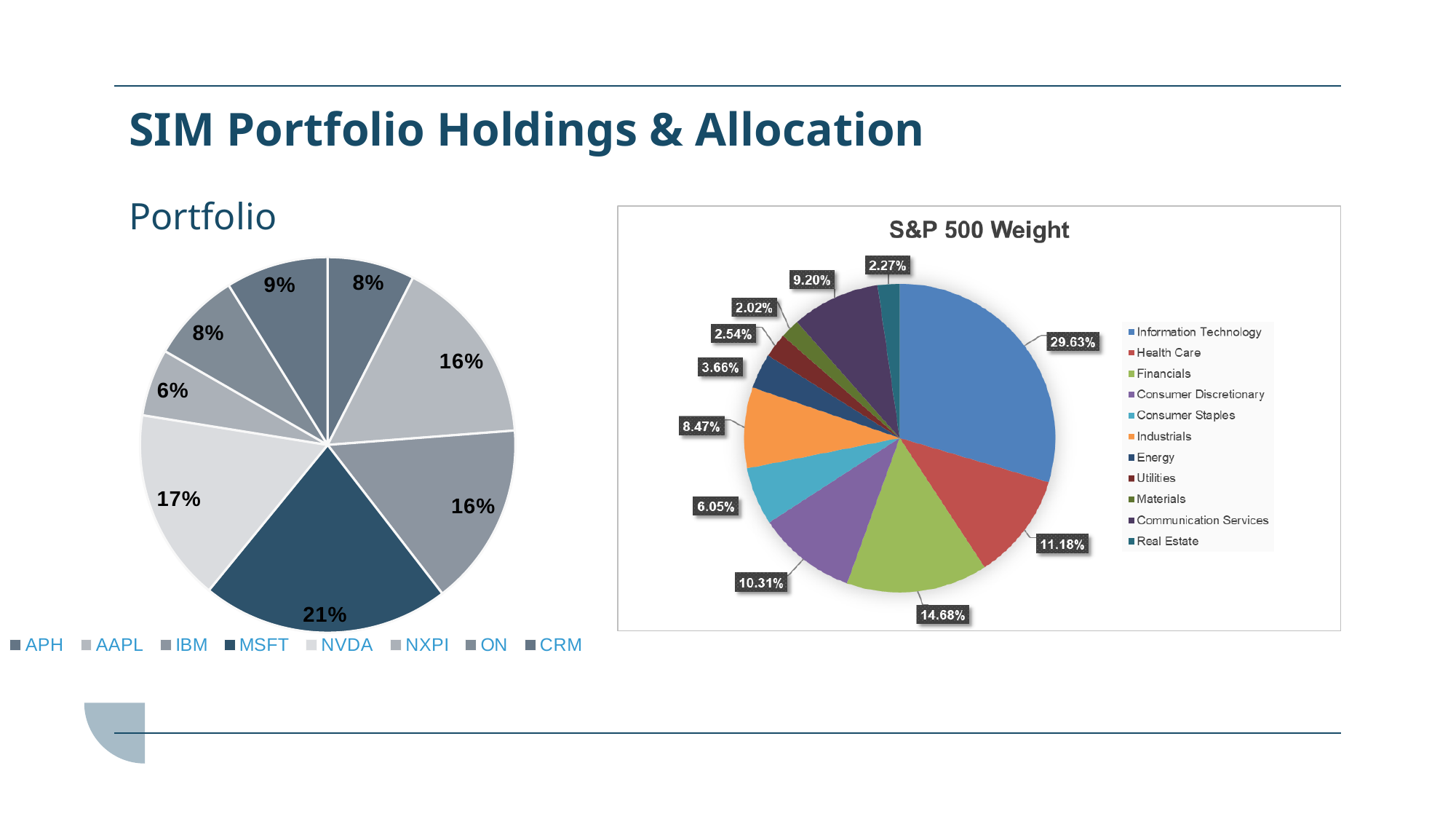
What is the title of the chart on the right side of the slide? S&P 500 Weight In the S&P 500 Weight chart, what is the weight of Information Technology? 29.63% In the Portfolio chart, what share does MSFT hold? 21% What type of chart is the Portfolio chart on the left? Pie chart In the Portfolio chart, which holding has the largest share? MSFT How many sectors does the legend of the S&P 500 Weight chart list? 11 How many holdings does the legend of the Portfolio chart list? 8 In the S&P 500 Weight chart, which sector has the smallest weight? Materials In the S&P 500 Weight chart, what is the weight of Financials? 14.68% In the S&P 500 Weight chart, which sector has the largest weight? Information Technology In the S&P 500 Weight chart, what is the difference between the Health Care and Consumer Discretionary weights? 0.87% In the S&P 500 Weight chart, which is larger, Industrials or Communication Services? Communication Services